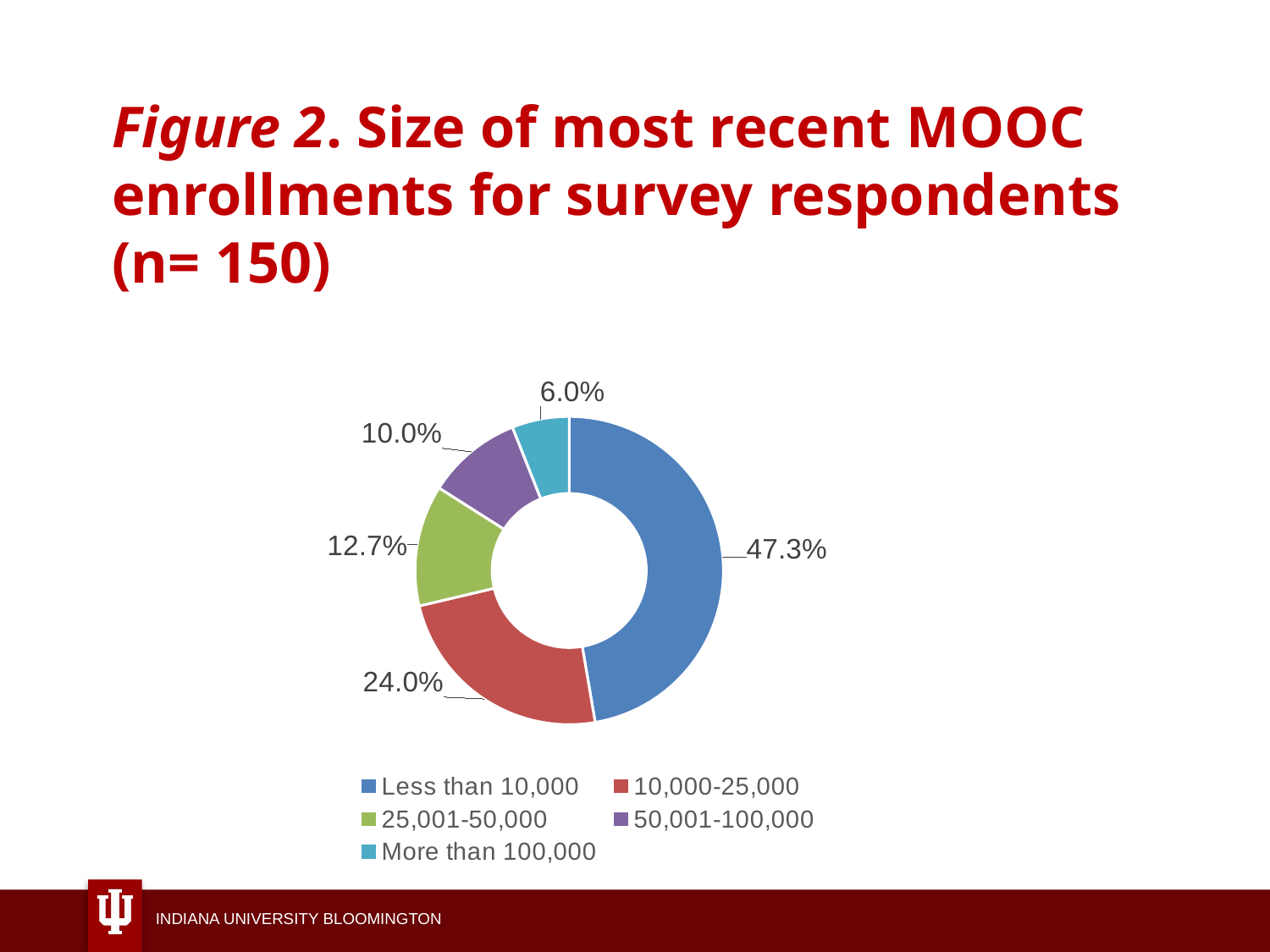
What colour represents the 10,000-25,000 category in the legend? Red What percentage of respondents reported enrollments of 10,000-25,000? 24.0% What percentage is shown for the 50,001-100,000 enrollment category? 10.0% Which category has a larger share: 25,001-50,000 or 50,001-100,000? 25,001-50,000 Which enrollment size category has the largest share? Less than 10,000 What percentage of respondents had more than 100,000 enrollments? 6.0% Which enrollment size category has the smallest share? More than 100,000 What is the difference in percentage points between the Less than 10,000 and 10,000-25,000 categories? 23.3 How many enrollment size categories are shown in the chart? 5 What type of chart is used on this slide? Doughnut (pie) chart What share of the chart is the 25,001-50,000 category? 12.7% What percentage of respondents had most recent MOOC enrollments of less than 10,000? 47.3%